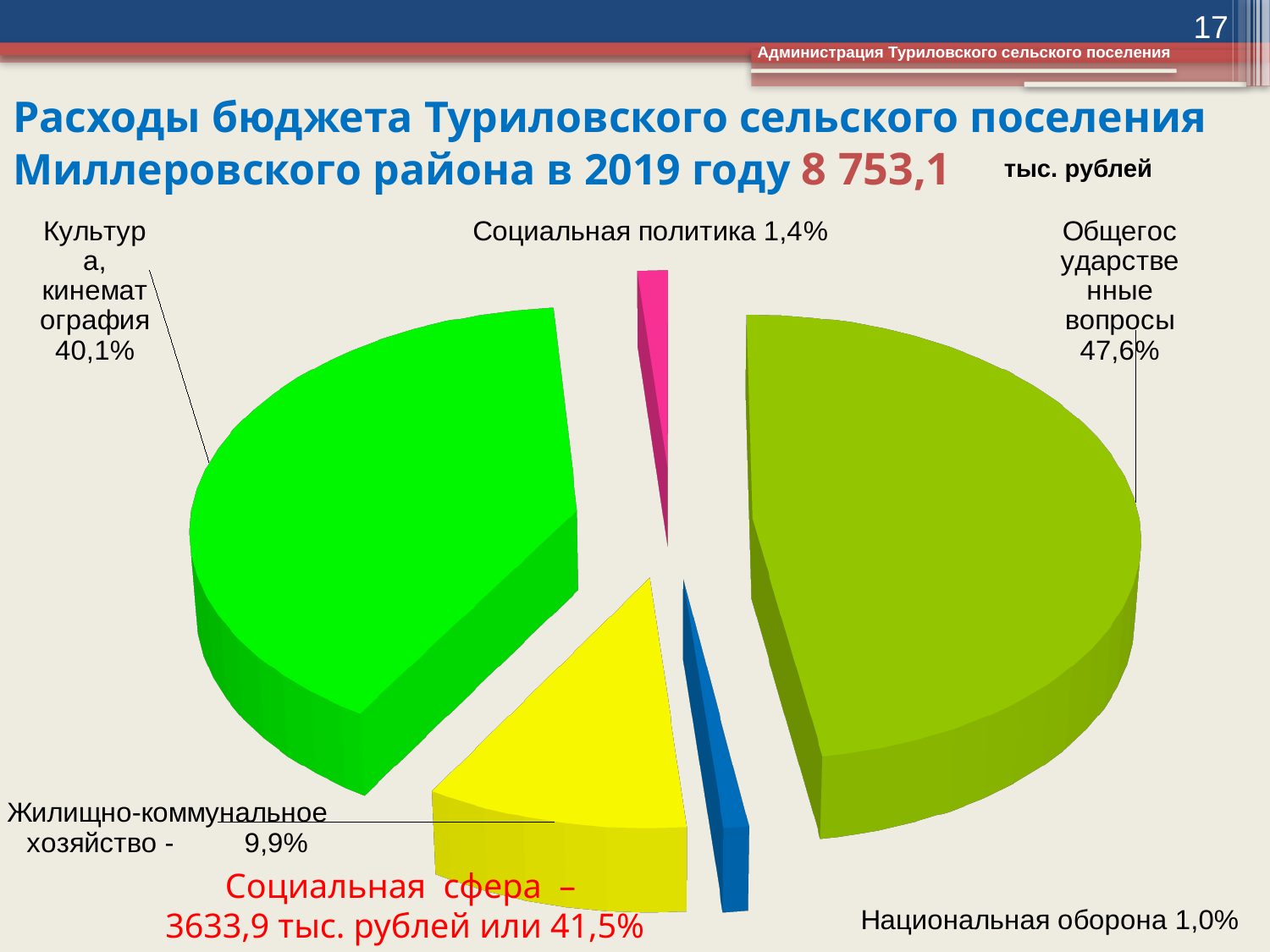
What is the difference in percentage points between "Общегосударственные вопросы" and "Культура, кинематография"? 7,5 What share of the pie does "Социальная политика" have? 1,4% What kind of chart is shown on the slide? Pie chart What share of the pie does "Культура, кинематография" have? 40,1% Which is larger: the share for "Жилищно-коммунальное хозяйство" or the share for "Социальная политика"? Жилищно-коммунальное хозяйство Which category has the largest share of the pie? Общегосударственные вопросы What share of the pie does "Общегосударственные вопросы" have? 47,6% How many slices does the pie chart have? 5 Which category has the smallest share of the pie? Национальная оборона What total budget expenditure amount (in тыс. рублей) is stated in the slide title? 8 753,1